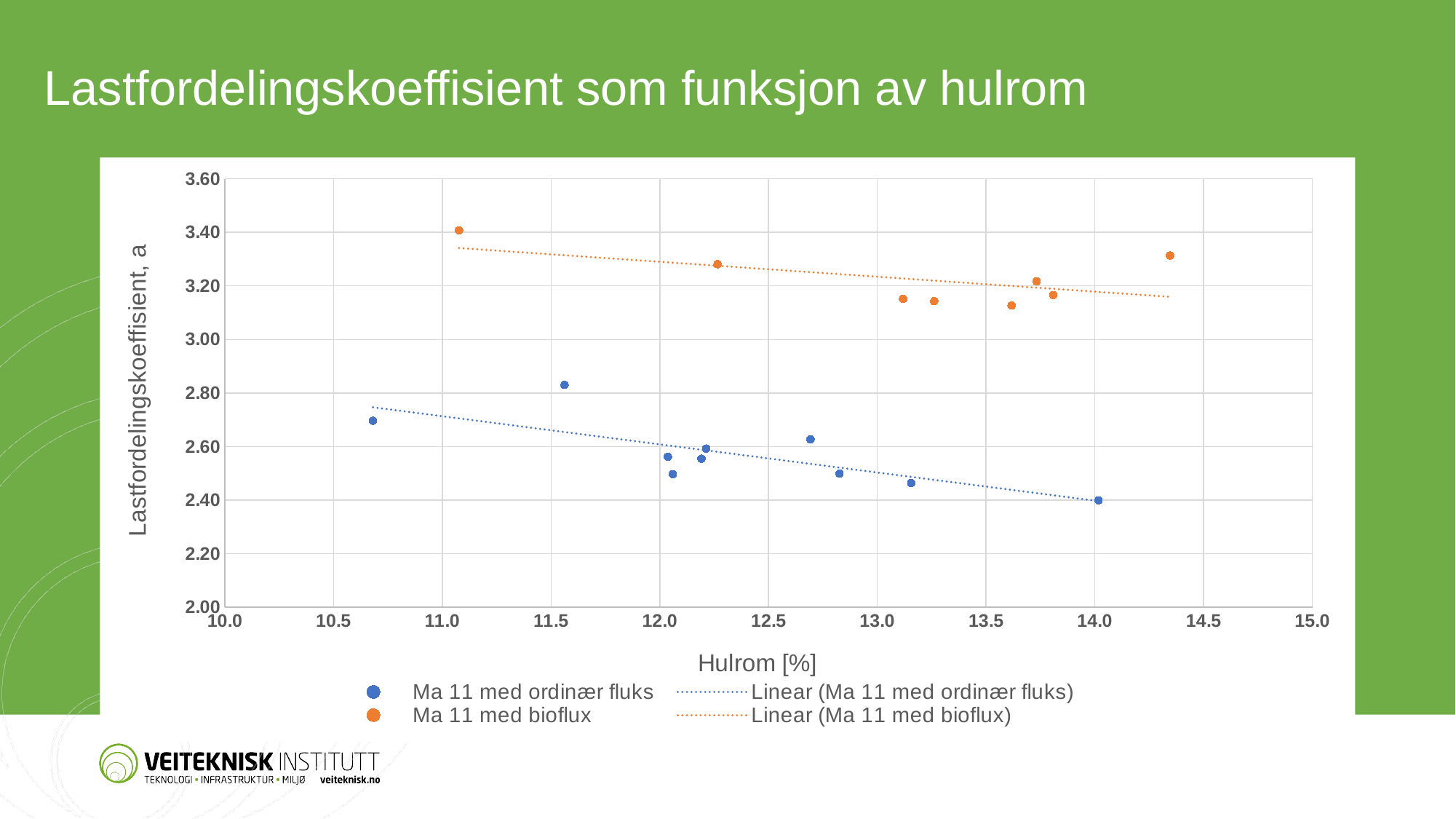
What is the label of the x axis? Hulrom [%] Does the linear trendline for 'Ma 11 med biofluks' rise or fall as Hulrom increases? Fall Which series has the higher Lastfordelingskoeffisient values overall, 'Ma 11 med ordinær fluks' or 'Ma 11 med biofluks'? Ma 11 med biofluks Which series is plotted with orange markers? Ma 11 med bioflux How many data points are plotted for the series 'Ma 11 med ordinær fluks'? 10 Is the Lastfordelingskoeffisient of the 'Ma 11 med ordinær fluks' point at about 14.0% Hulrom greater or less than 2.60? less Does the linear trendline for 'Ma 11 med ordinær fluks' rise or fall as Hulrom increases? Fall What kind of chart is shown on the slide? Scatter chart How many entries does the legend list? 4 How many data points are plotted for the series 'Ma 11 med biofluks'? 8 Are all the points of the series 'Ma 11 med biofluks' greater or less than 3.00 on the y axis? greater What is the title of the chart? Lastfordelingskoeffisient som funksjon av hulrom